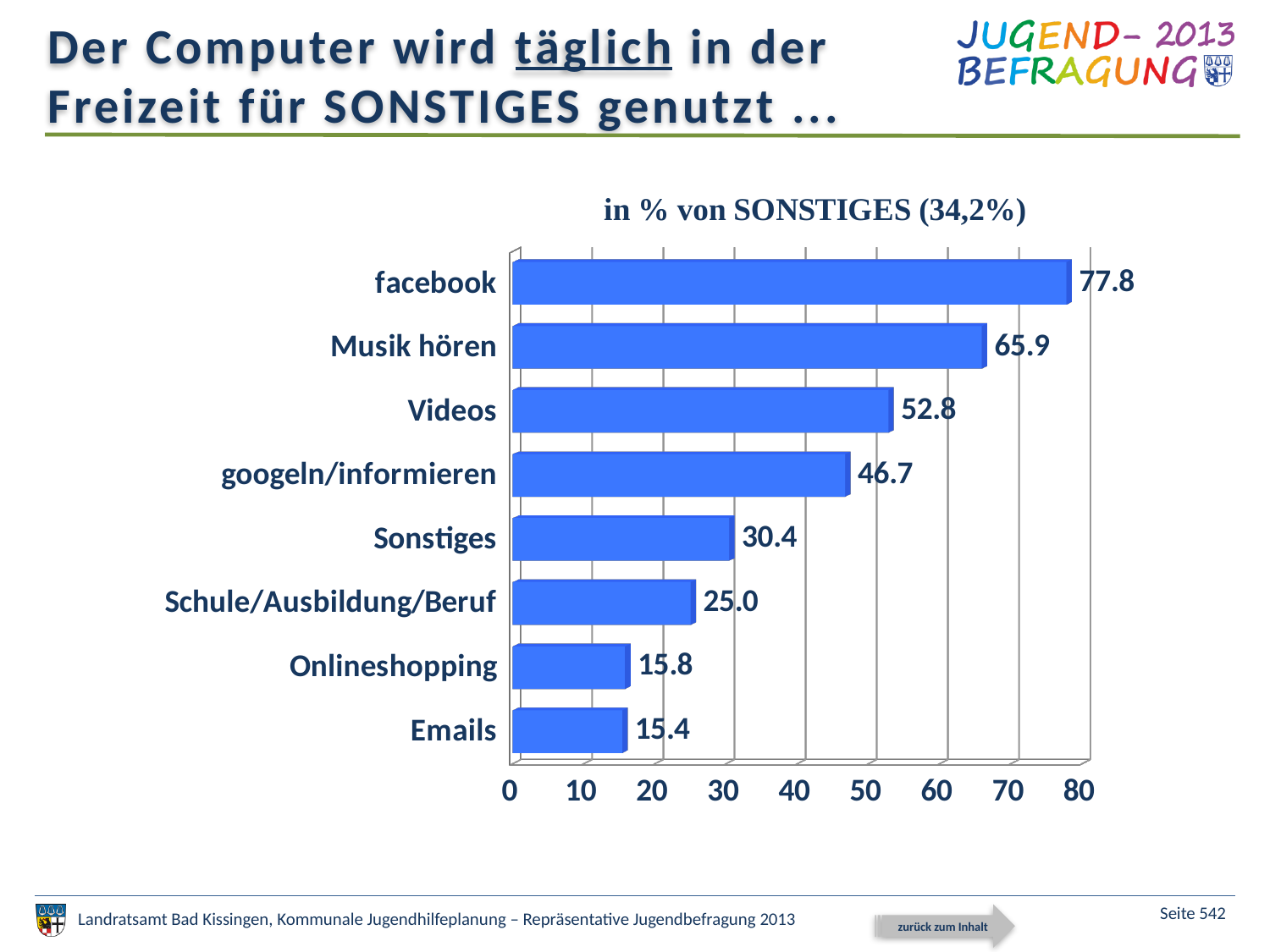
What is the value for Onlineshopping? 15.8 What is the difference between the values for Videos and googeln/informieren? 6.1 What kind of chart is shown on the slide? bar chart Is the value for Videos greater or less than 50? greater Which category has the lowest value? Emails What is the title of the chart? in % von SONSTIGES (34,2%) What is the value for facebook? 77.8 Which category has the highest value? facebook What is the difference between the values for facebook and Musik hören? 11.9 What is the value for Musik hören? 65.9 Which is larger, the value for Sonstiges or the value for Schule/Ausbildung/Beruf? Sonstiges How many categories are shown in the chart? 8